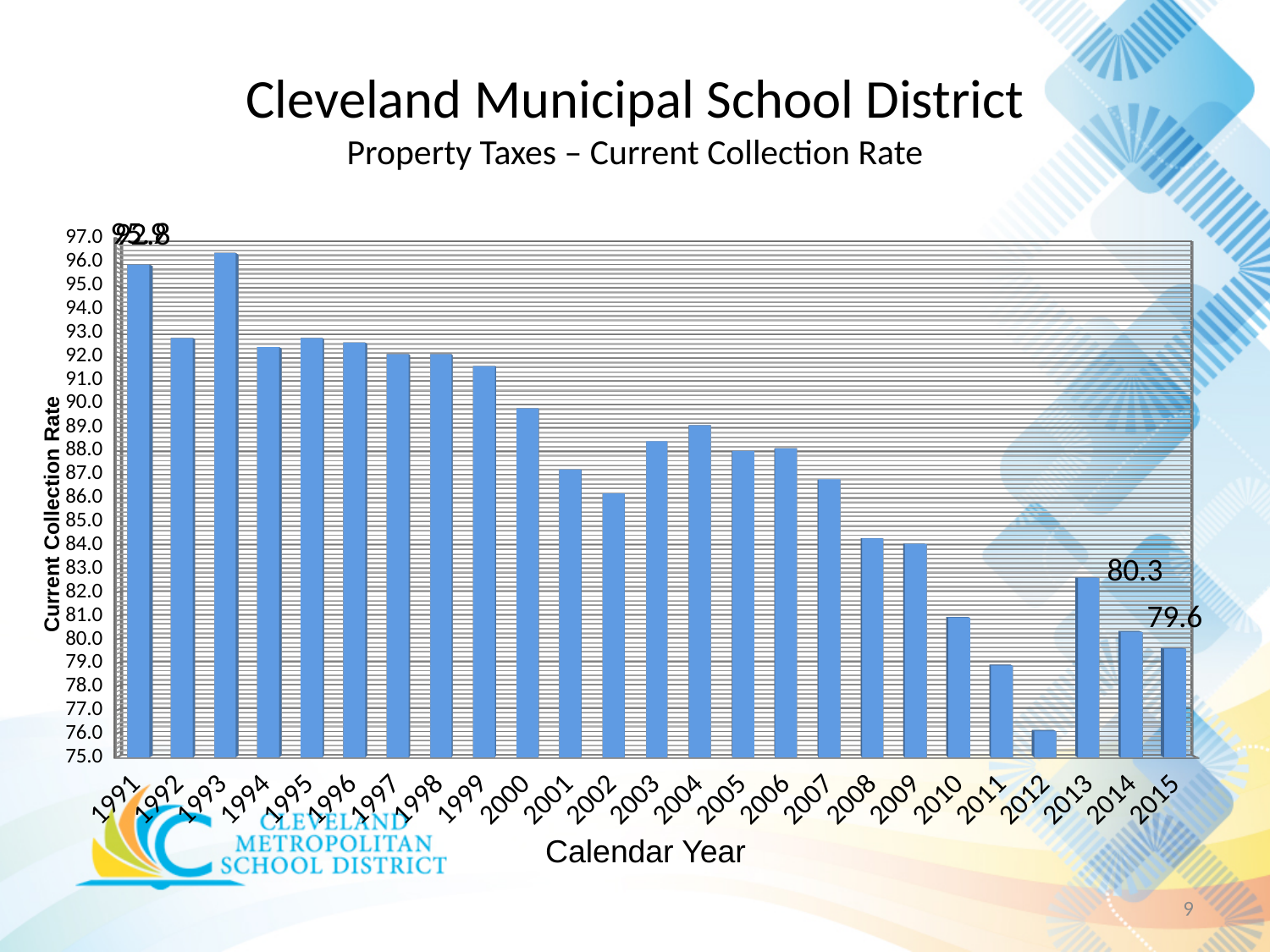
Which calendar year has the highest current collection rate? 1993 What kind of chart is shown on the slide? bar chart How many calendar years are plotted on the x axis? 25 Is the value for 2000 greater or less than 89.0? greater What is the label on the y axis? Current Collection Rate Which calendar year has the lowest current collection rate? 2012 Overall, do the collection rates rise or fall from 1991 to 2015? fall What is the current collection rate for 2014? 80.3 What is the current collection rate for 2015? 79.6 Is the value for 2011 greater or less than 80.0? less What is the difference between the collection rates for 2014 and 2015? 0.7 Which year has the larger collection rate, 2004 or 2005? 2004